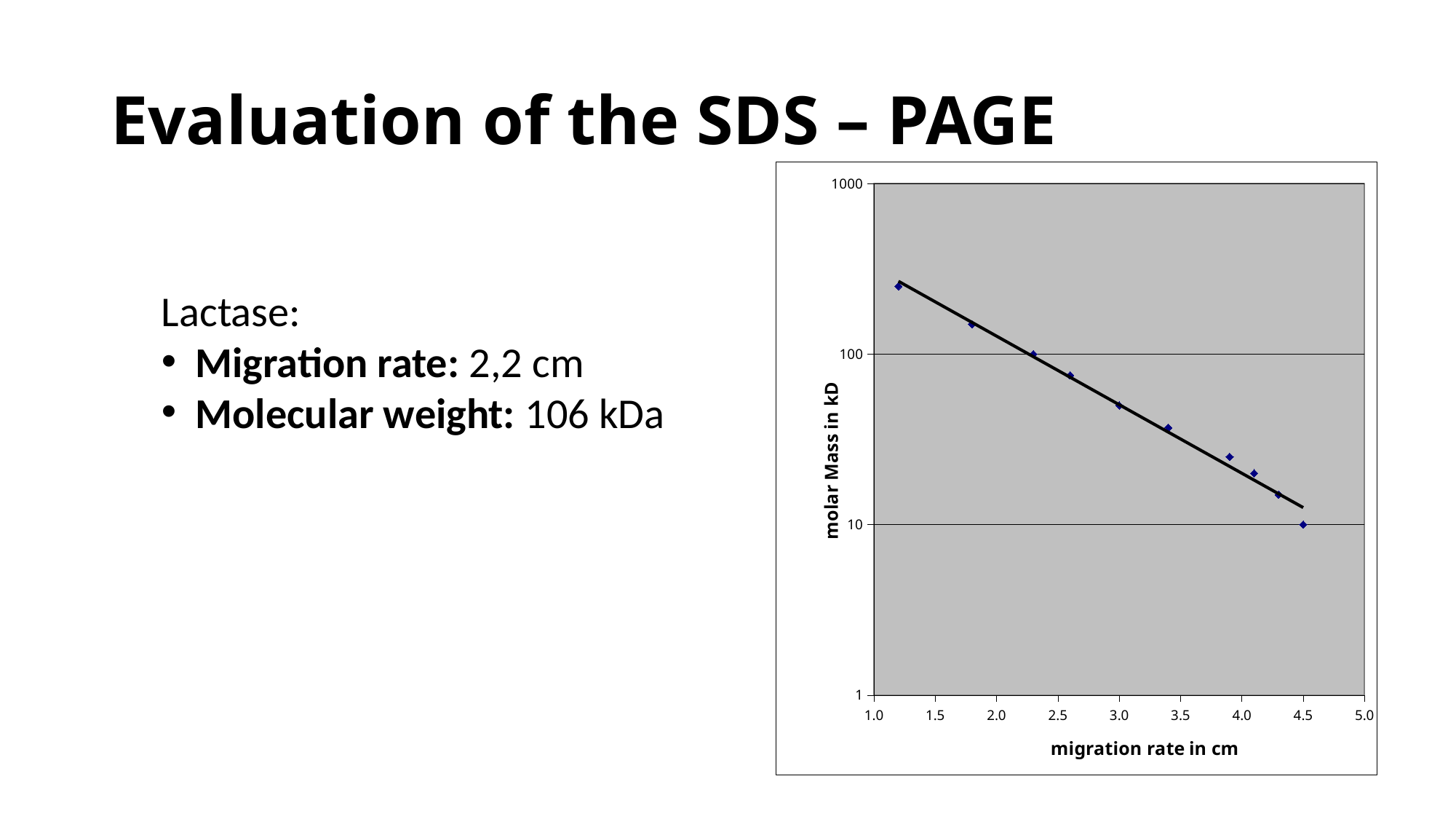
What is the title of the x axis of the chart? migration rate in cm Is the molar mass of the point at a migration rate of 3.4 cm greater or less than 100? less What kind of chart is shown on the slide? scatter chart Is the molar mass of the point at a migration rate of 3.0 cm greater or less than 10? greater At which migration rate does the plotted point have the lowest molar mass? 4.5 cm What is the title of the y axis of the chart? molar Mass in kD Do the plotted molar mass values rise or fall as the migration rate increases along the x axis? fall Is the molar mass of the point at a migration rate of 4.5 cm greater or less than 100? less How many data points are plotted on the chart? 10 Which point has the larger molar mass: the one at a migration rate of 1.8 cm or the one at 3.4 cm? 1.8 cm